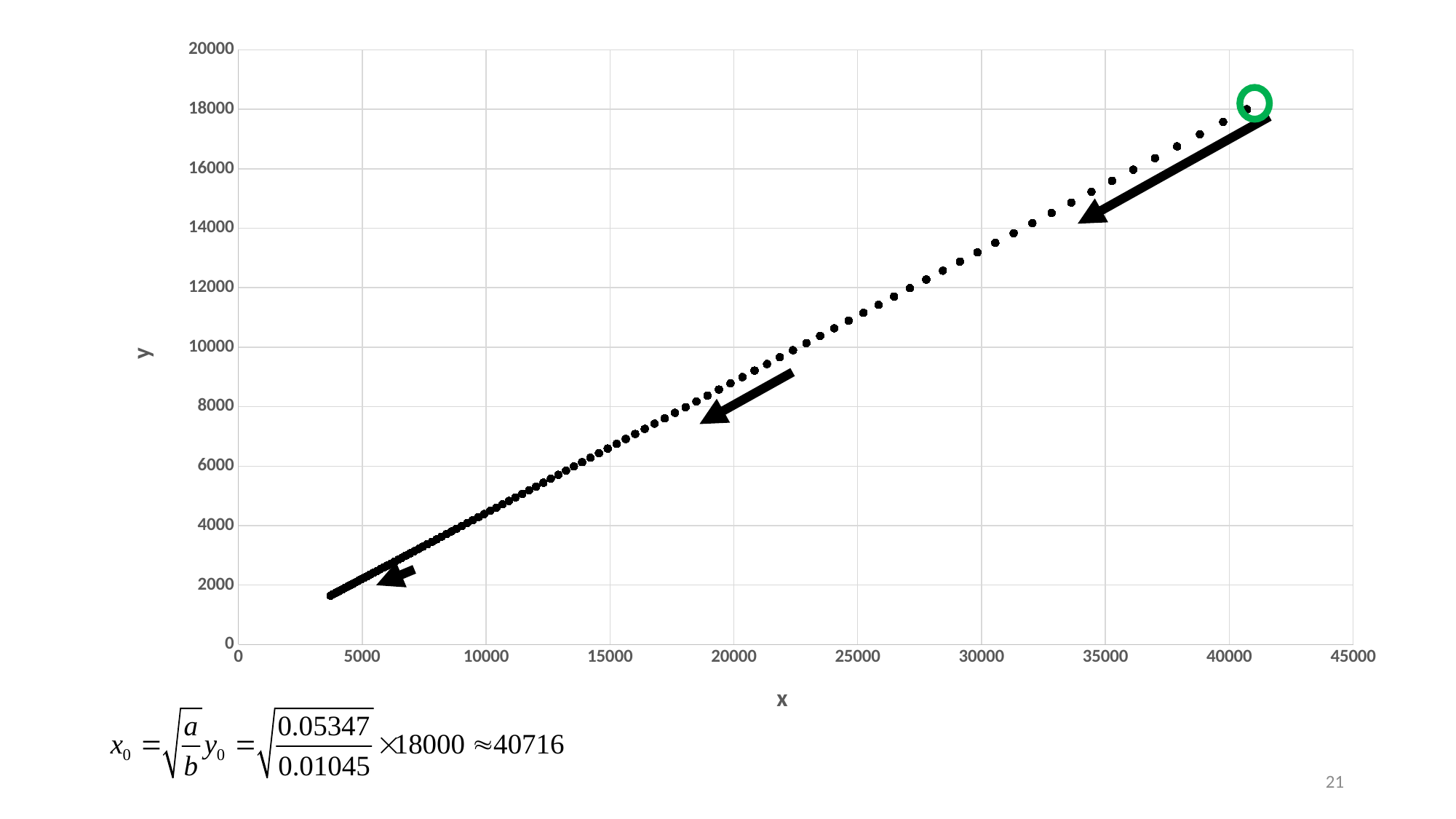
What is the highest tick value shown on the y axis? 20000 Is the x value of the point marked with the green circle greater or less than 35000? greater What kind of chart is shown on the slide? scatter chart Is the y value of the lowest plotted point greater or less than 4000? less Do the y values rise or fall as x increases along the x axis? rise What is the label of the horizontal axis? x What is the label of the vertical axis? y